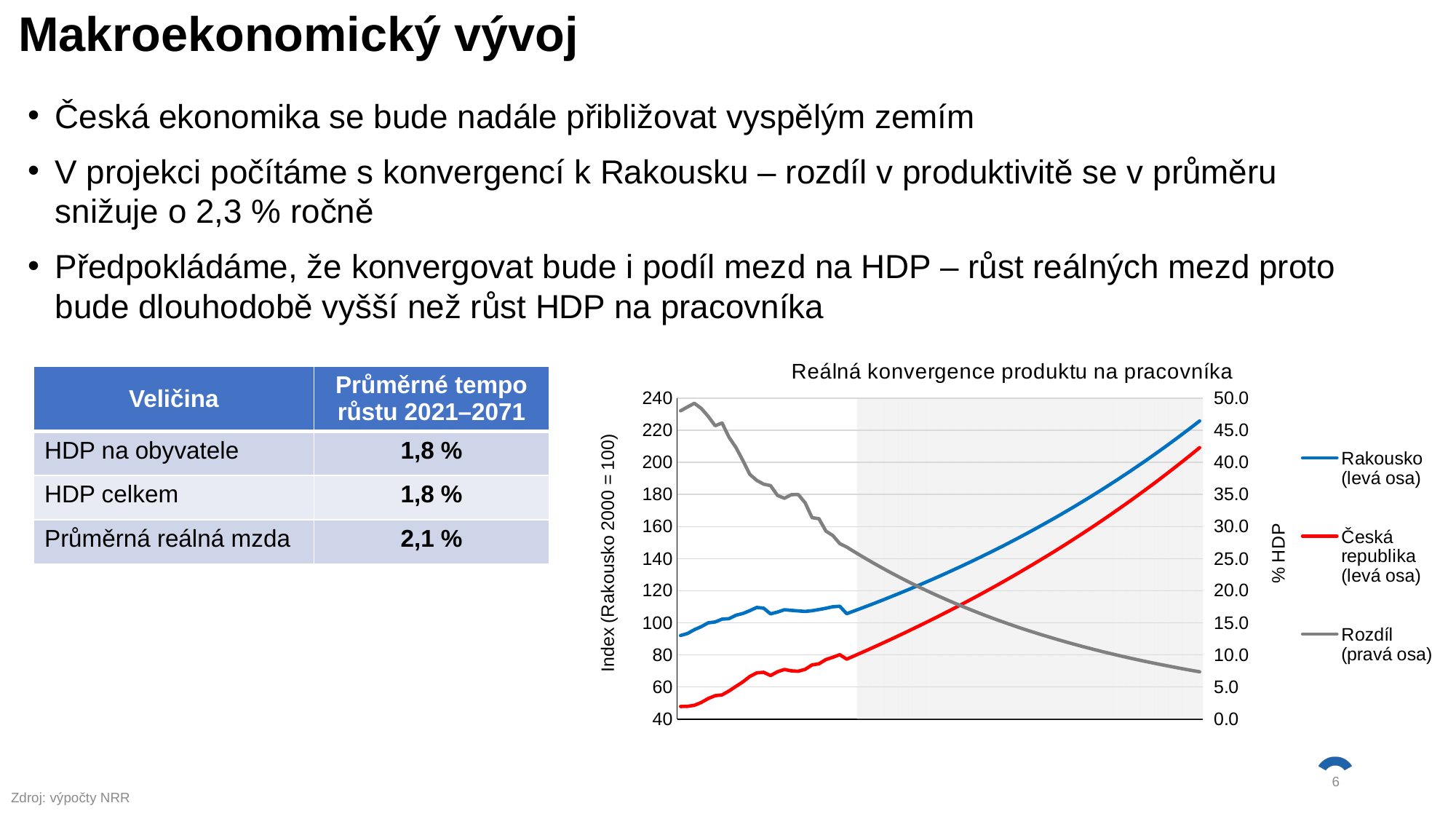
What is the title of the chart on the slide? Reálná konvergence produktu na pracovníka Does the Rozdíl series rise or fall along the x axis? fall Is the value of the Rakousko series at the right end of the chart greater or less than 220? greater How many series does the chart's legend list? 3 Is the value of the Česká republika series at the left end of the chart greater or less than 60? less Does the Česká republika series rise or fall along the x axis? rise Which series in the chart is plotted on the right axis (pravá osa)? Rozdíl Is the value of the Rozdíl series at the right end of the chart greater or less than 10.0 on the right axis? less At the right end of the chart, which series is higher on the left axis: Rakousko or Česká republika? Rakousko What kind of chart is shown on the slide? line chart